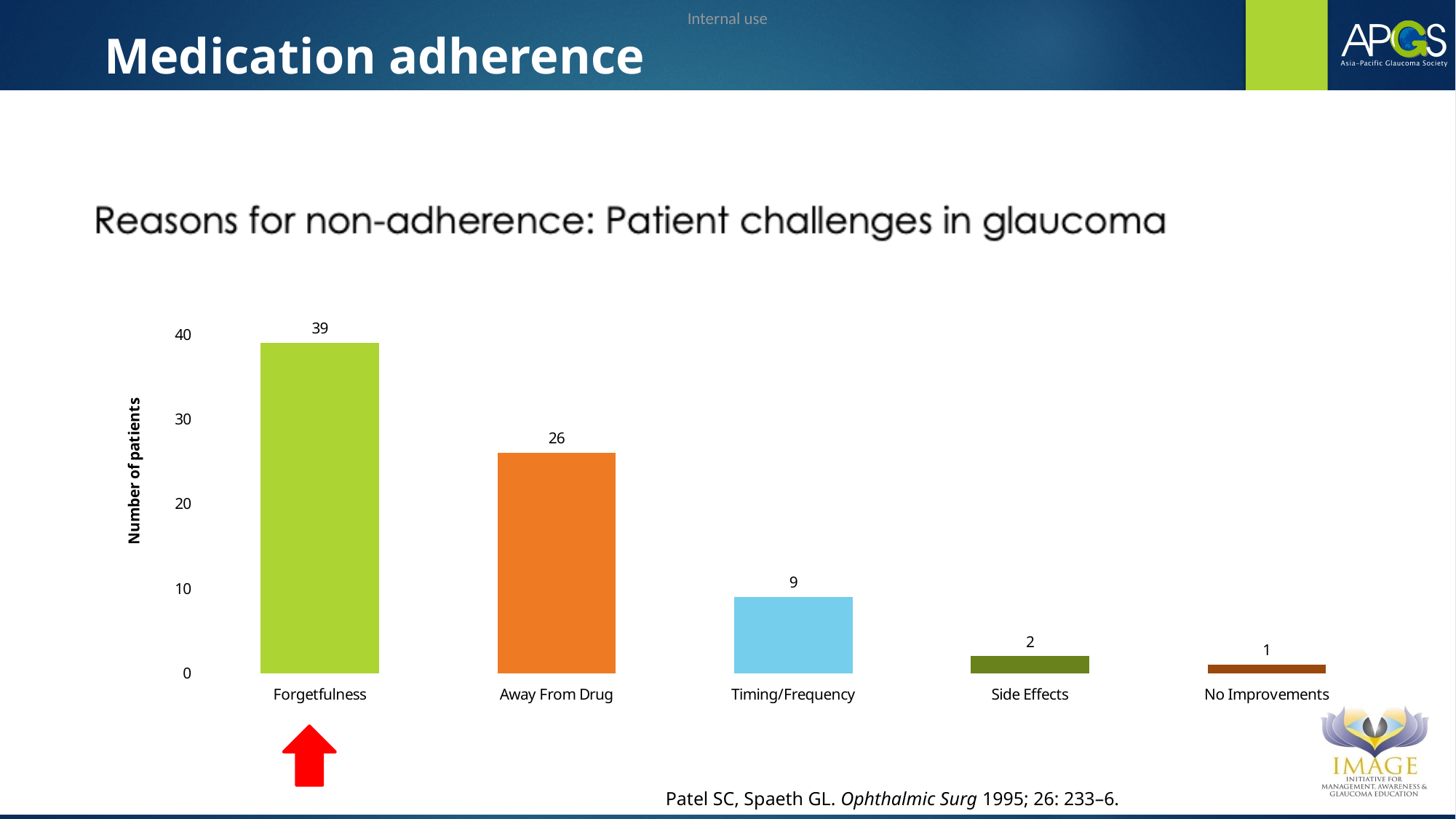
How many reasons for non-adherence are shown on the chart? 5 What is the number of patients for Timing/Frequency? 9 What is the label of the vertical axis? Number of patients What is the difference in number of patients between Forgetfulness and Away From Drug? 13 Do the values rise or fall from left to right across the categories? Fall Which reason for non-adherence has the highest number of patients? Forgetfulness What is the number of patients for Side Effects? 2 What is the number of patients for Away From Drug? 26 Which has more patients, Timing/Frequency or Side Effects? Timing/Frequency How many patients cited Forgetfulness as a reason for non-adherence? 39 What type of chart is used to show the reasons for non-adherence? Bar chart Which reason for non-adherence has the lowest number of patients? No Improvements